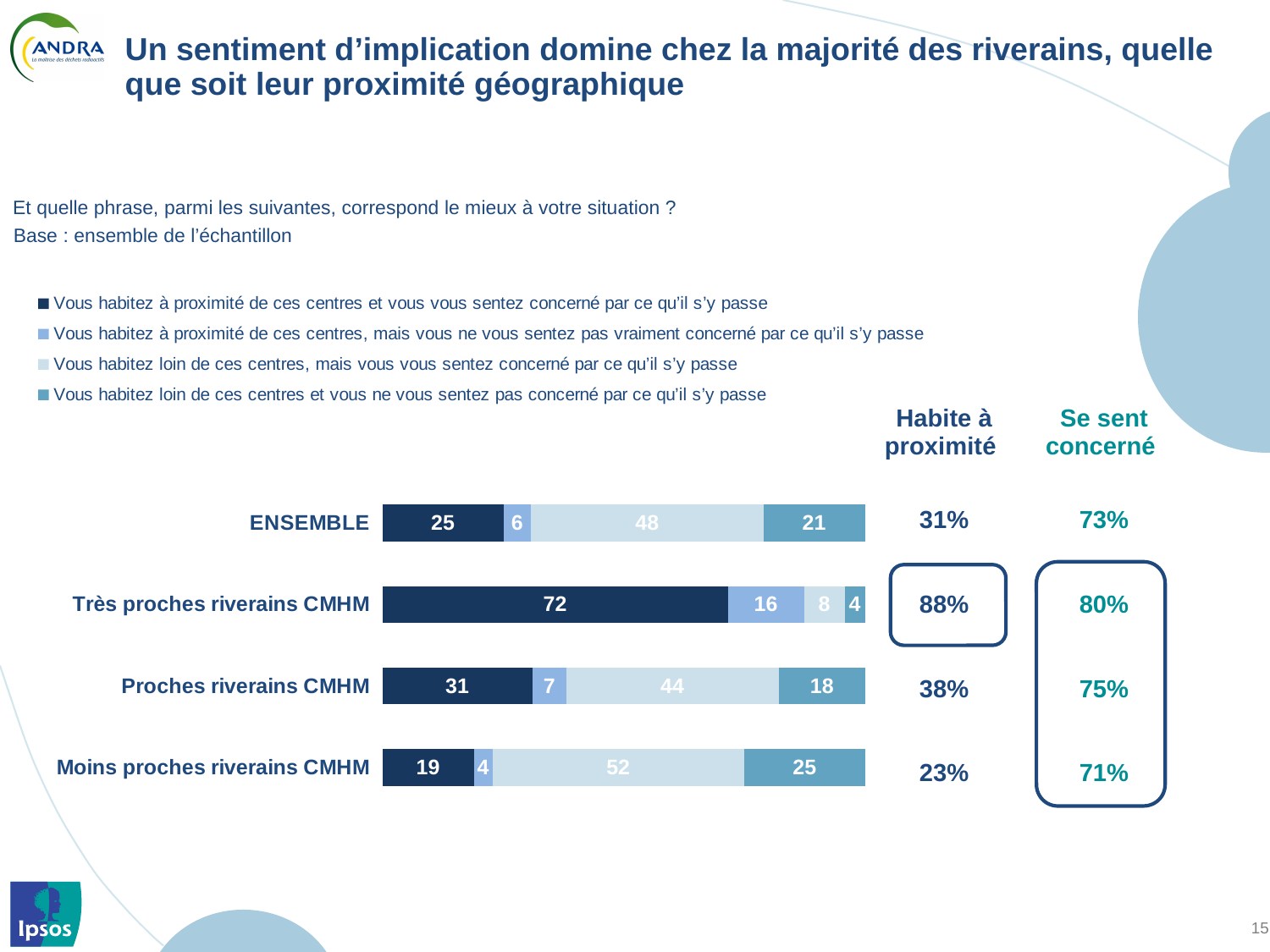
What is the 'Habite à proximité' percentage shown for Proches riverains CMHM? 38% Which category has the highest value for 'Vous habitez à proximité de ces centres et vous vous sentez concerné par ce qu'il s'y passe'? Très proches riverains CMHM What is the value for 'Vous habitez à proximité de ces centres et vous vous sentez concerné par ce qu'il s'y passe' for Très proches riverains CMHM? 72 How many series does the legend list? 4 For 'Vous habitez loin de ces centres, mais vous vous sentez concerné', which is larger: Proches riverains CMHM or Moins proches riverains CMHM? Moins proches riverains CMHM What is the value for 'Vous habitez loin de ces centres, mais vous vous sentez concerné par ce qu'il s'y passe' for Moins proches riverains CMHM? 52 What is the value for 'Vous habitez loin de ces centres et vous ne vous sentez pas concerné par ce qu'il s'y passe' for ENSEMBLE? 21 How many categories (rows) are plotted in the bar chart? 4 What is the difference between the 'Vous habitez à proximité de ces centres et vous vous sentez concerné' values for Proches riverains CMHM and ENSEMBLE? 6 What is the total of the stacked bar for Très proches riverains CMHM? 100 What kind of chart is shown on the slide? Stacked bar chart Which category has the lowest 'Se sent concerné' percentage? Moins proches riverains CMHM